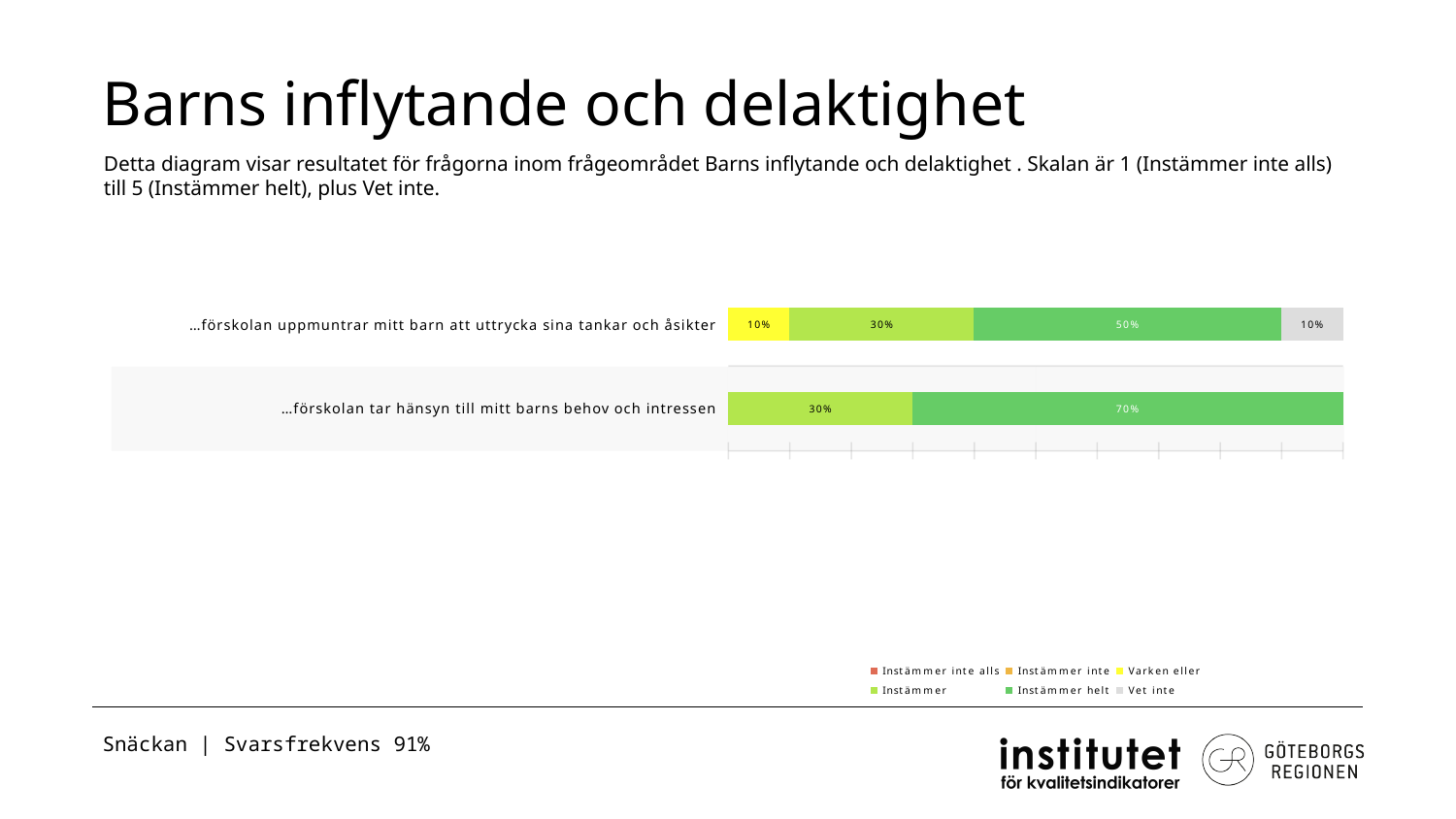
What is the 'Varken eller' value for '…förskolan uppmuntrar mitt barn att uttrycka sina tankar och åsikter'? 10% What is the 'Instämmer helt' value for '…förskolan uppmuntrar mitt barn att uttrycka sina tankar och åsikter'? 50% Which category has the higher 'Instämmer helt' value? …förskolan tar hänsyn till mitt barns behov och intressen What is the difference in 'Instämmer helt' between '…förskolan tar hänsyn till mitt barns behov och intressen' and '…förskolan uppmuntrar mitt barn att uttrycka sina tankar och åsikter'? 20% What is the 'Vet inte' value for '…förskolan uppmuntrar mitt barn att uttrycka sina tankar och åsikter'? 10% What kind of chart is shown on the slide? Stacked bar chart Which legend entry is shown in grey? Vet inte What is the combined share of 'Instämmer' and 'Instämmer helt' for '…förskolan tar hänsyn till mitt barns behov och intressen'? 100% Is the 'Instämmer' value larger for '…förskolan uppmuntrar mitt barn att uttrycka sina tankar och åsikter' or for '…förskolan tar hänsyn till mitt barns behov och intressen'? They are equal (30%) How many series does the legend list? 6 How many categories (questions) are plotted in the chart? 2 What is the 'Instämmer helt' value for '…förskolan tar hänsyn till mitt barns behov och intressen'? 70%